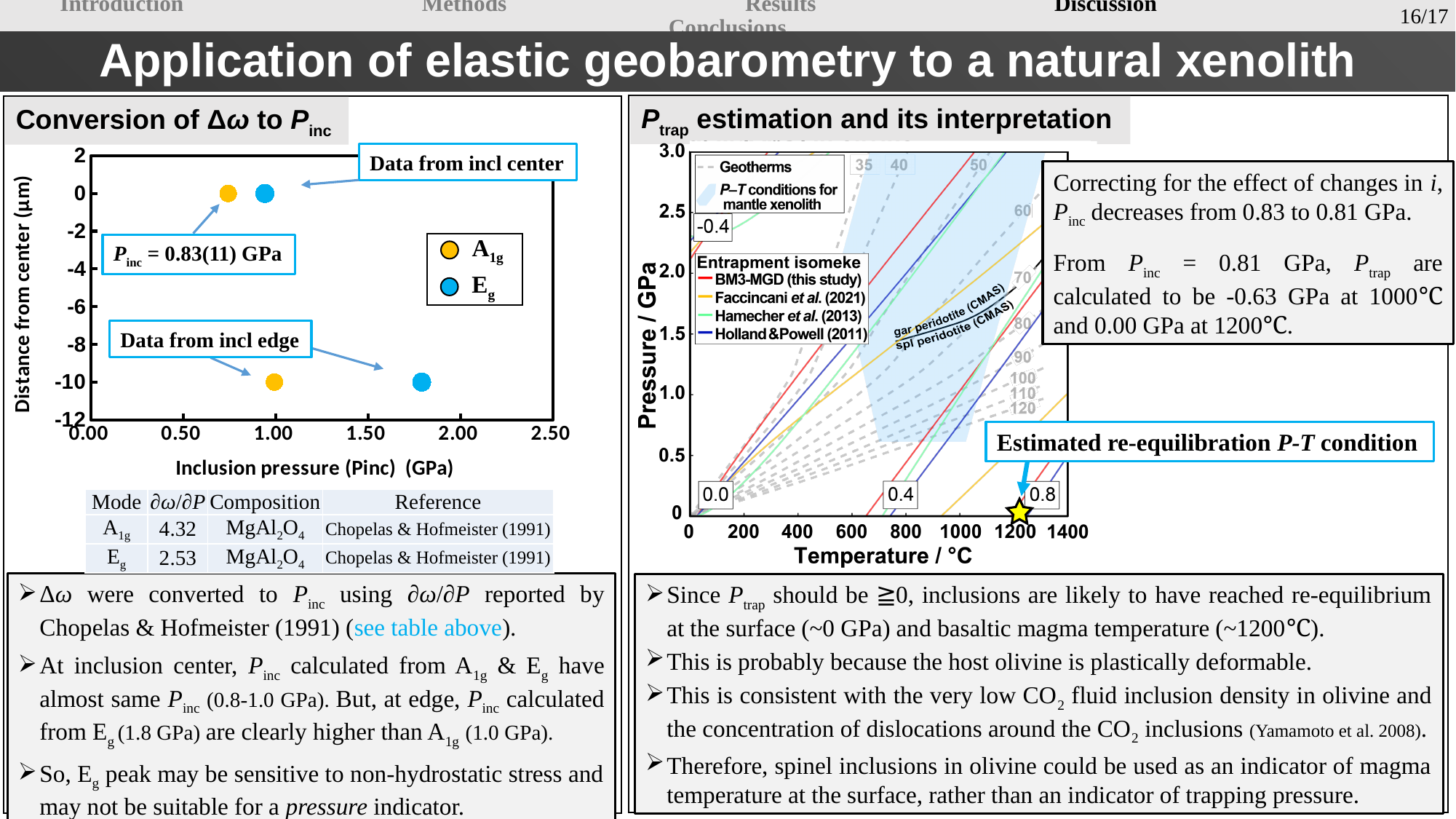
On the left chart 'Conversion of Δω to Pinc', is the inclusion pressure of the A1g point at the inclusion center (0 μm) greater or less than 1.00 GPa? less On the left chart 'Conversion of Δω to Pinc', how many data points are plotted in total? 4 On the left chart 'Conversion of Δω to Pinc', which point has the lowest inclusion pressure? A1g at the inclusion center (0 μm) On the left chart 'Conversion of Δω to Pinc', what is the label of the x axis? Inclusion pressure (Pinc) (GPa) On the left chart 'Conversion of Δω to Pinc', is the inclusion pressure of the Eg point at the inclusion edge (-10 μm) greater or less than 1.50 GPa? greater On the left chart 'Conversion of Δω to Pinc', at the inclusion edge (-10 μm), which series has the larger inclusion pressure, A1g or Eg? Eg On the left chart 'Conversion of Δω to Pinc', what kind of chart is it? scatter chart On the left chart 'Conversion of Δω to Pinc', which point has the highest inclusion pressure? Eg at the inclusion edge (-10 μm) On the left chart 'Conversion of Δω to Pinc', how many series does the legend list? 2 On the left chart 'Conversion of Δω to Pinc', what are the two series named in the legend? A1g and Eg On the right P–T chart, at what temperature is the star marking the estimated re-equilibration P-T condition plotted? 1200 °C On the right P–T chart, how many entrapment isomeke lines are listed in the legend? 4